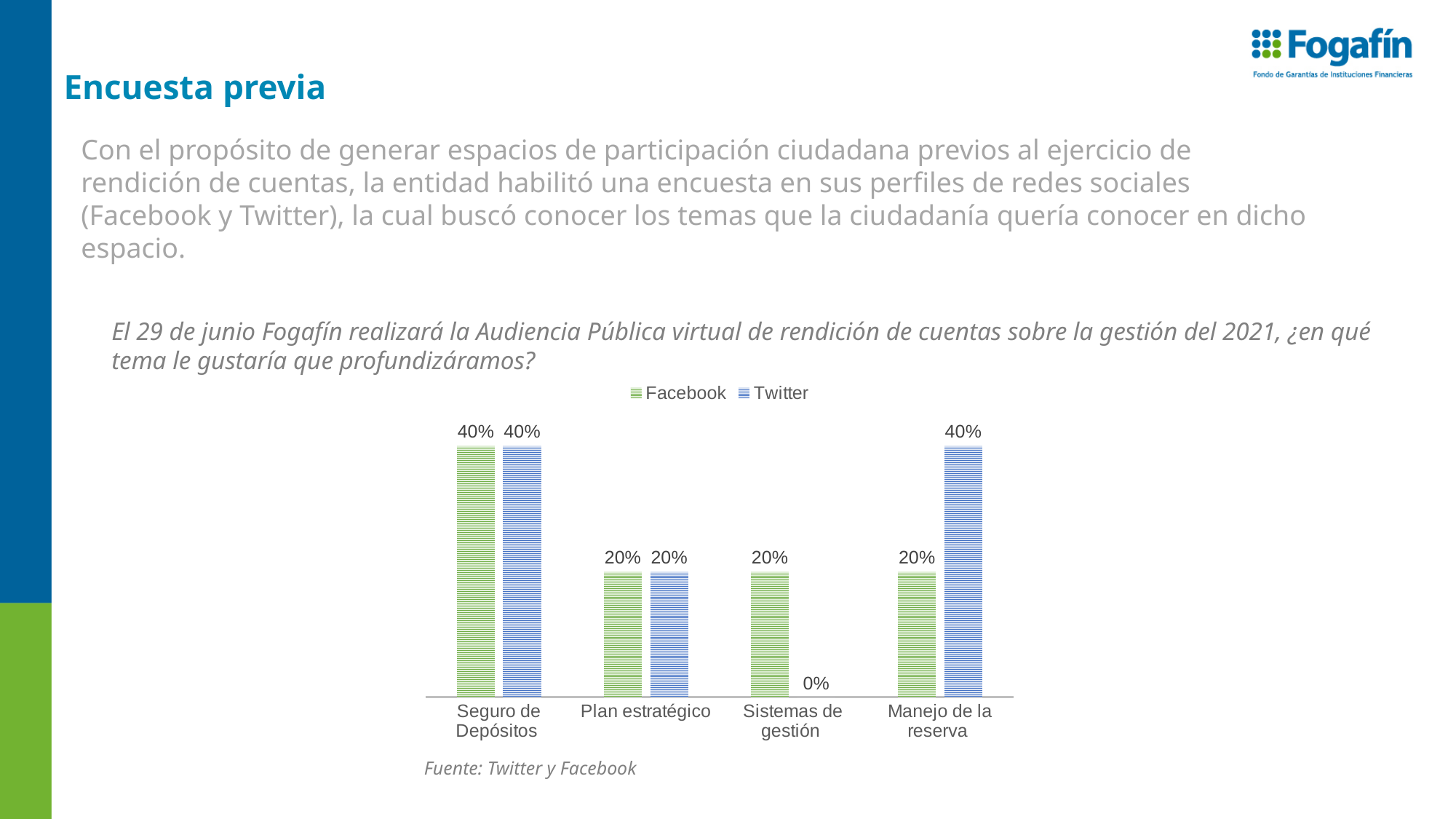
What is the difference between the Twitter and Facebook values for Manejo de la reserva? 20% What is the Facebook value for Plan estratégico? 20% Which category has the lowest Twitter value? Sistemas de gestión What is the Facebook value for Seguro de Depósitos? 40% What kind of chart is shown on the slide? Bar chart How many categories are shown on the x axis of the chart? 4 How many series does the chart legend list? 2 What source is cited below the chart? Twitter y Facebook For Manejo de la reserva, which is larger, the Facebook value or the Twitter value? Twitter What is the Twitter value for Sistemas de gestión? 0% What is the Twitter value for Manejo de la reserva? 40% Which category has the highest Facebook value? Seguro de Depósitos